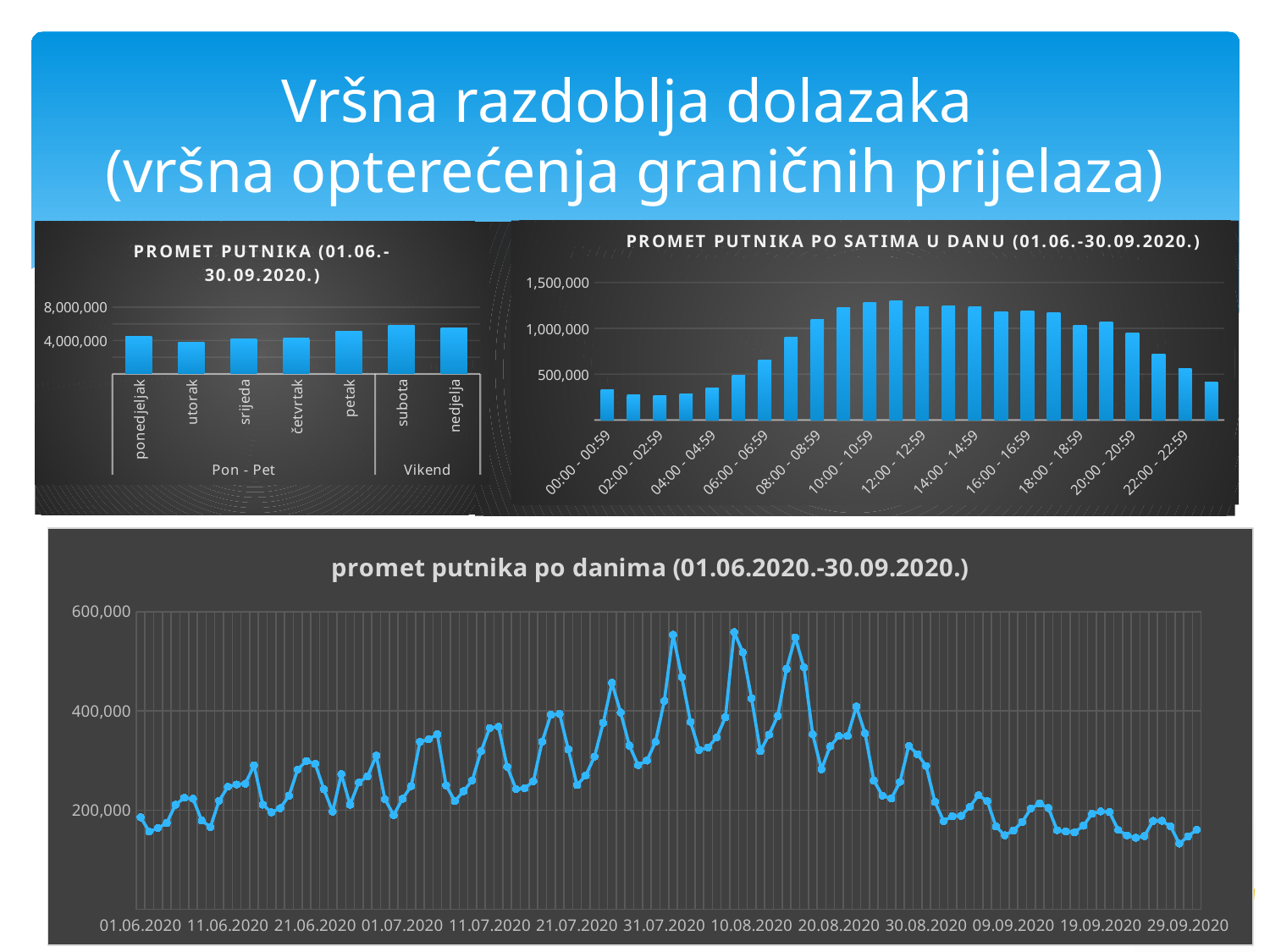
In the top-left chart 'PROMET PUTNIKA (01.06.-30.09.2020.)', which is larger, the value for petak or the value for utorak? petak In the top-left chart 'PROMET PUTNIKA (01.06.-30.09.2020.)', which day has the highest value? subota In the top-right chart 'PROMET PUTNIKA PO SATIMA U DANU (01.06.-30.09.2020.)', which is larger, the value for 10:00 - 10:59 or the value for 02:00 - 02:59? 10:00 - 10:59 In the top-left chart 'PROMET PUTNIKA (01.06.-30.09.2020.)', how many days are shown on the x axis? 7 What type of chart is the chart titled 'PROMET PUTNIKA (01.06.-30.09.2020.)' at the top left? bar chart In the top-right chart 'PROMET PUTNIKA PO SATIMA U DANU (01.06.-30.09.2020.)', how many bars are plotted? 24 In the bottom chart 'promet putnika po danima (01.06.2020.-30.09.2020.)', do the values generally rise or fall between 10.08.2020 and 29.09.2020? fall In the top-right chart 'PROMET PUTNIKA PO SATIMA U DANU (01.06.-30.09.2020.)', is the value for 10:00 - 10:59 greater or less than 1,000,000? greater What type of chart is the bottom chart 'promet putnika po danima (01.06.2020.-30.09.2020.)'? line chart In the top-right chart 'PROMET PUTNIKA PO SATIMA U DANU (01.06.-30.09.2020.)', is the value for 00:00 - 00:59 greater or less than 500,000? less In the top-left chart 'PROMET PUTNIKA (01.06.-30.09.2020.)', what are the two group labels shown below the day names? Pon - Pet and Vikend In the top-left chart 'PROMET PUTNIKA (01.06.-30.09.2020.)', is the value for subota greater or less than 4,000,000? greater